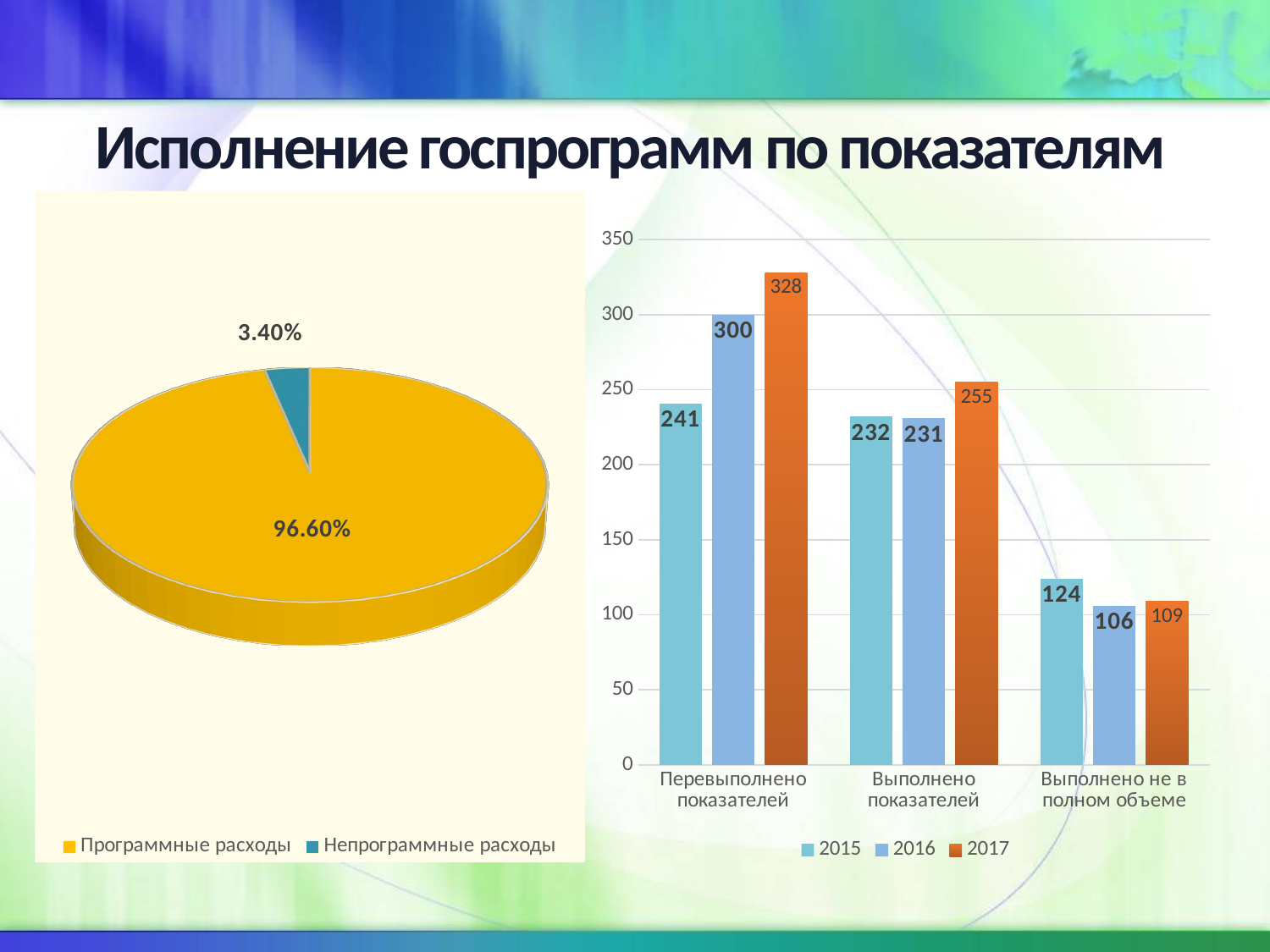
In the pie chart on the left, what share does Программные расходы have? 96.60% In the bar chart on the right, what is the value for 2016 in the category Выполнено показателей? 231 In the bar chart on the right, which is larger for Выполнено не в полном объеме: the 2015 value or the 2016 value? 2015 In the bar chart on the right, which category has the highest value for 2016? Перевыполнено показателей In the pie chart on the left, what share does Непрограммные расходы have? 3.40% What kind of chart is the chart on the right of the slide? Bar chart In the bar chart on the right, what is the value for 2017 in the category Перевыполнено показателей? 328 In the bar chart on the right, which category has the lowest value for 2017? Выполнено не в полном объеме How many series does the legend of the bar chart on the right list? 3 In the bar chart on the right, what is the value for 2015 in the category Выполнено не в полном объеме? 124 In the bar chart on the right, what is the difference between the 2017 and 2015 values for Перевыполнено показателей? 87 What kind of chart is the chart on the left of the slide? Pie chart